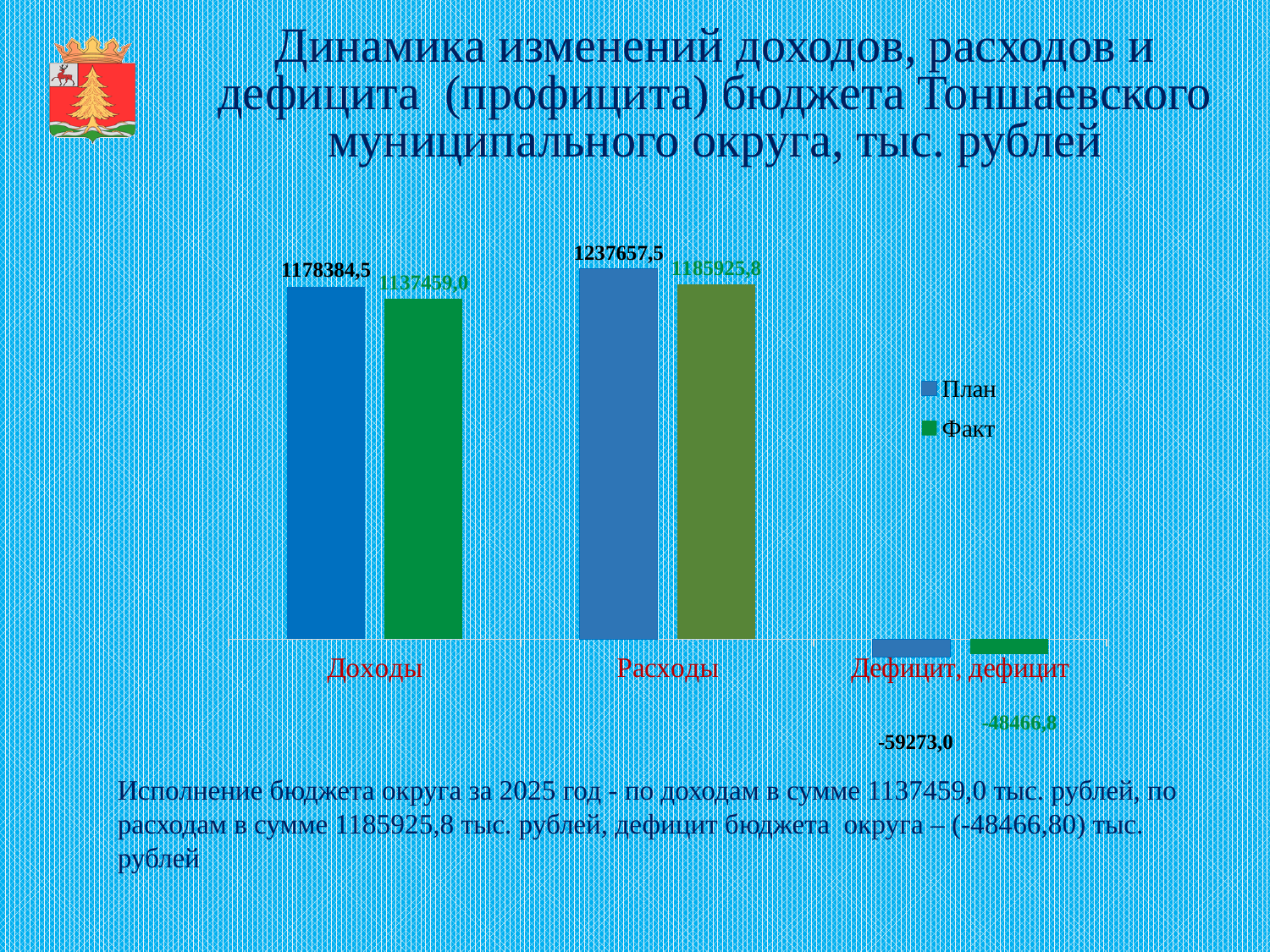
What is the План value for Расходы? 1237657,5 What kind of chart is shown on the slide? Bar chart What is the Факт value for Дефицит, дефицит? -48466,8 What is the difference between the План and Факт values for Расходы? 51731,7 What is the Факт value for Доходы? 1137459,0 Which category has the highest План value? Расходы What is the Факт value for Расходы? 1185925,8 How many series does the legend list? 2 Which is larger, the Факт value for Доходы or the Факт value for Расходы? Факт value for Расходы What is the План value for Доходы? 1178384,5 What is the difference between the План and Факт values for Доходы? 40925,5 What is the План value for Дефицит, дефицит? -59273,0